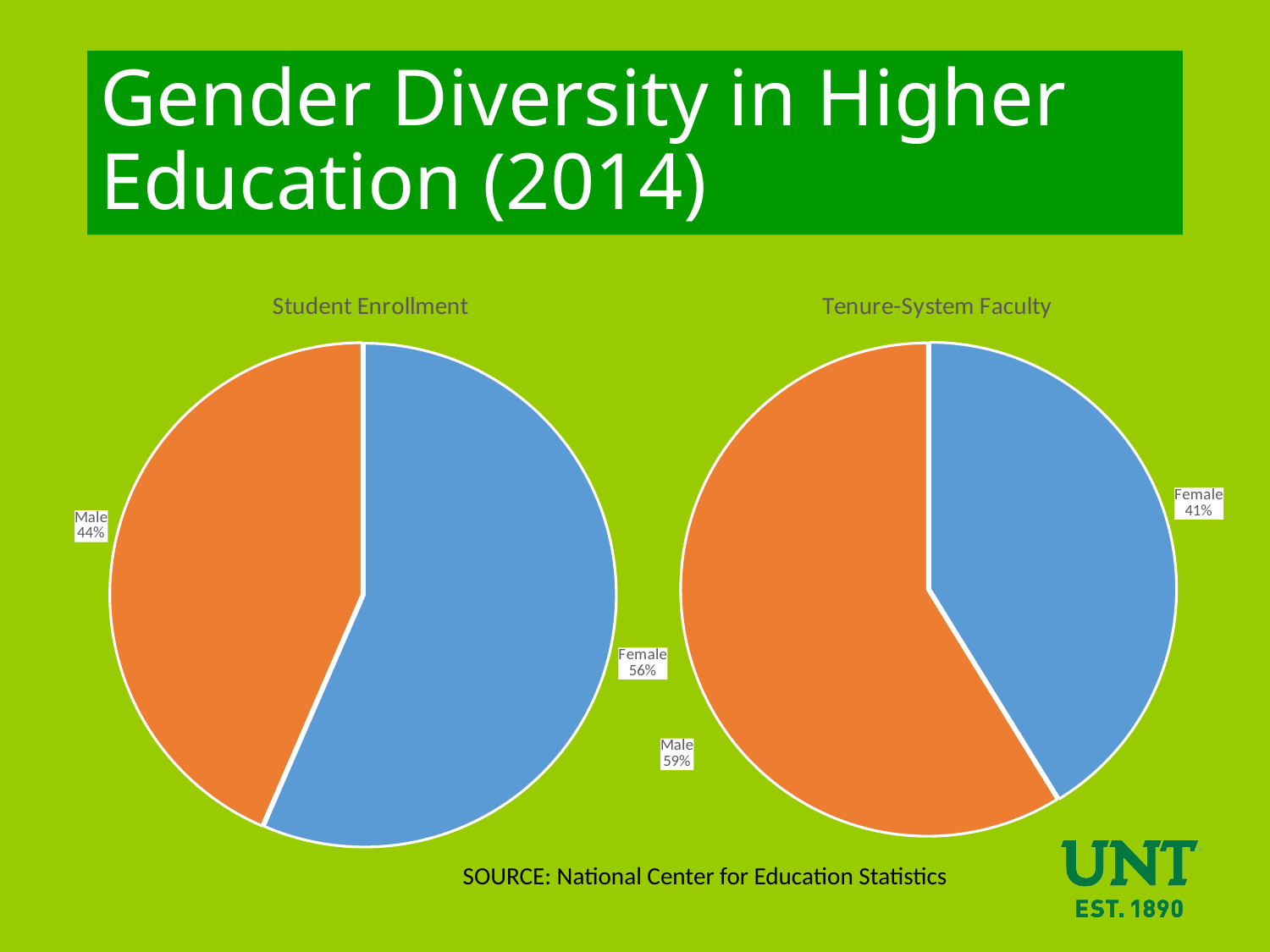
In the Student Enrollment chart, what is the difference in percentage points between Female and Male? 12 In the Student Enrollment chart, what percentage is Male? 44% In the Tenure-System Faculty chart, what percentage is Male? 59% In the Tenure-System Faculty chart, which slice is the largest? Male What kind of chart is the Student Enrollment chart? Pie chart In the Tenure-System Faculty chart, what is the difference in percentage points between Male and Female? 18 In the Tenure-System Faculty chart, which slice is the smallest? Female How many slices does the Tenure-System Faculty chart have? 2 In the Tenure-System Faculty chart, what percentage is Female? 41% In the Student Enrollment chart, which slice is larger, Female or Male? Female What is the title of the chart on the right side of the slide? Tenure-System Faculty In the Student Enrollment chart, what percentage is Female? 56%